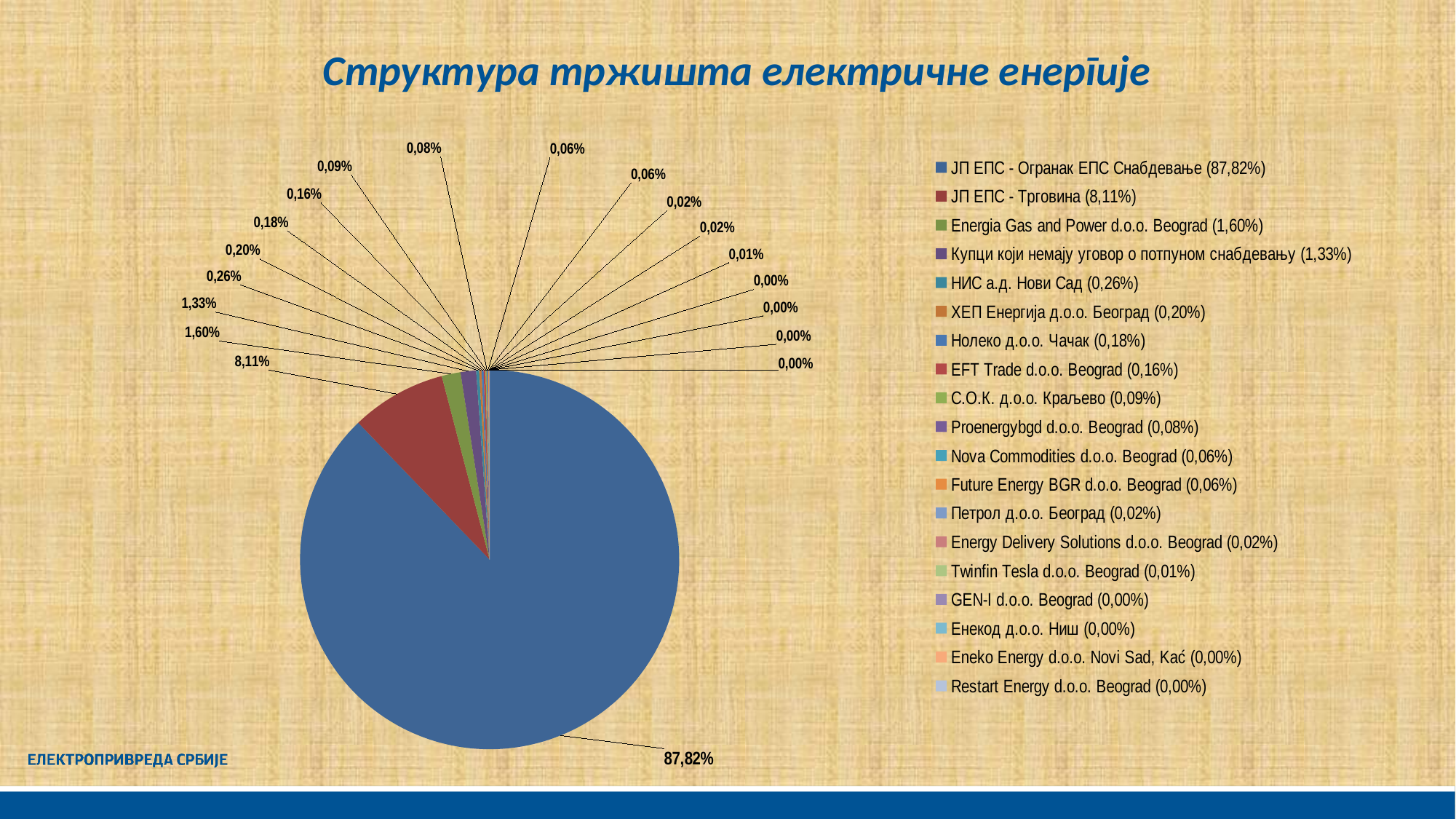
What share of the market does ЈП ЕПС - Огранак ЕПС Снабдевање hold? 87,82% What kind of chart is shown on the slide? pie chart What is the difference between the shares of ЈП ЕПС - Огранак ЕПС Снабдевање and ЈП ЕПС - Трговина? 79,71% What is the value shown for Energia Gas and Power d.o.o. Beograd? 1,60% How many categories does the legend list? 19 Which is larger: the share of Energia Gas and Power d.o.o. Beograd or the share of Купци који немају уговор о потпуном снабдевању? Energia Gas and Power d.o.o. Beograd What is the value shown for НИС а.д. Нови Сад? 0,26% What is the title of the chart? Структура тржишта електричне енергије Which category has the largest slice of the pie? ЈП ЕПС - Огранак ЕПС Снабдевање What is the value shown for ЈП ЕПС - Трговина? 8,11% What is the combined share of ЈП ЕПС - Огранак ЕПС Снабдевање and ЈП ЕПС - Трговина? 95,93% What is the value shown for Twinfin Tesla d.o.o. Beograd? 0,01%